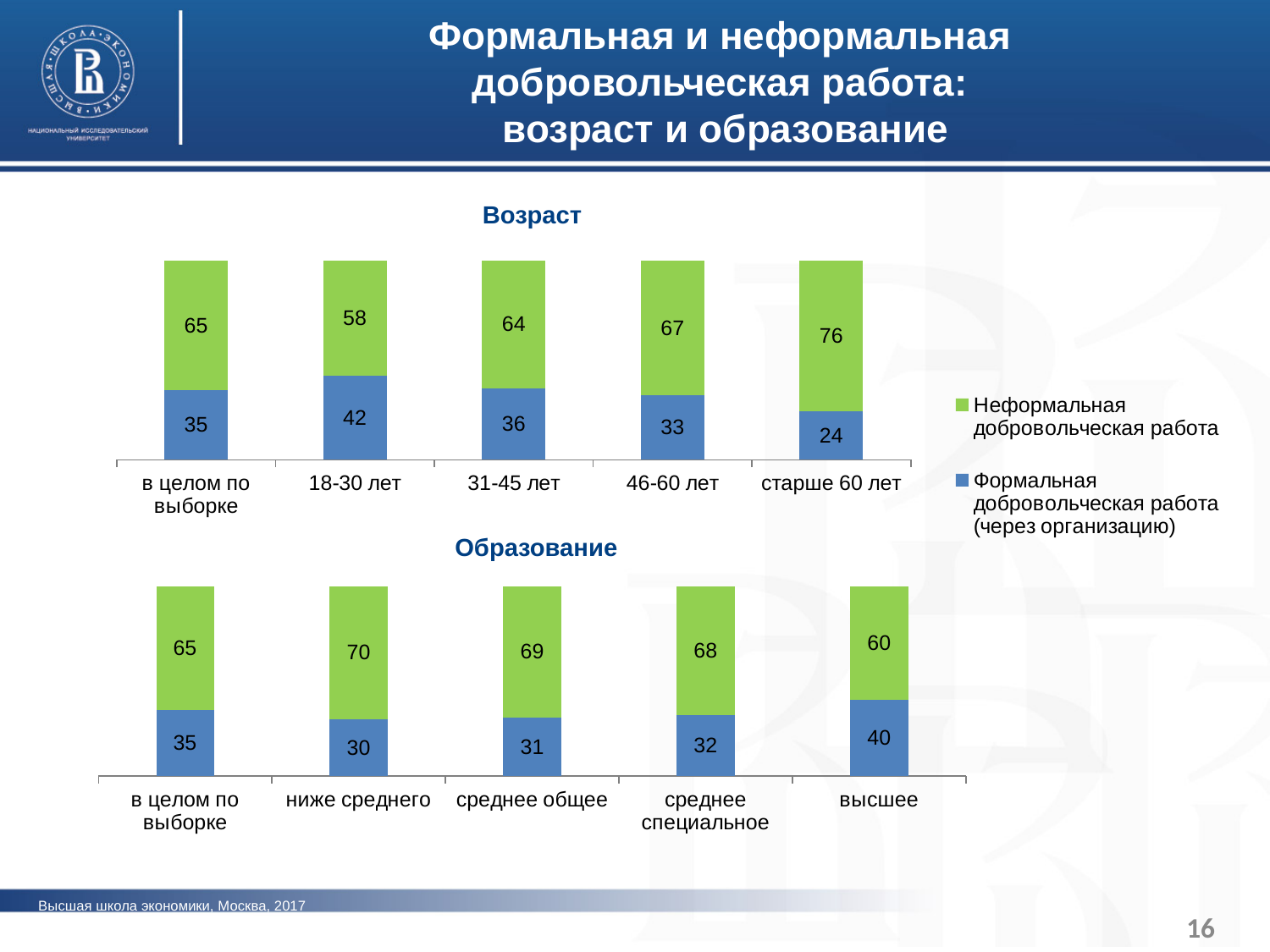
In the 'Возраст' chart, what is the value for Неформальная добровольческая работа for the 'старше 60 лет' category? 76 What type of chart is the 'Возраст' chart? Stacked bar chart How many categories are shown in the 'Образование' chart? 5 How many series does the legend list? 2 In the 'Образование' chart, what is the value for Формальная добровольческая работа for the 'высшее' category? 40 In the 'Возраст' chart, which age category has the lowest value for Формальная добровольческая работа? старше 60 лет In the 'Возраст' chart, what is the difference between the Формальная values for '18-30 лет' and 'старше 60 лет'? 18 In the 'Образование' chart, which is larger: the Неформальная value for 'ниже среднего' or for 'высшее'? ниже среднего In the 'Образование' chart, which category has the highest value for Формальная добровольческая работа? высшее In the 'Возраст' chart, what is the value for Формальная добровольческая работа for the '18-30 лет' category? 42 In the 'Возраст' chart, which category has the highest value for Неформальная добровольческая работа? старше 60 лет In the 'Возраст' chart, what is the total of the stacked bar for '46-60 лет'? 100